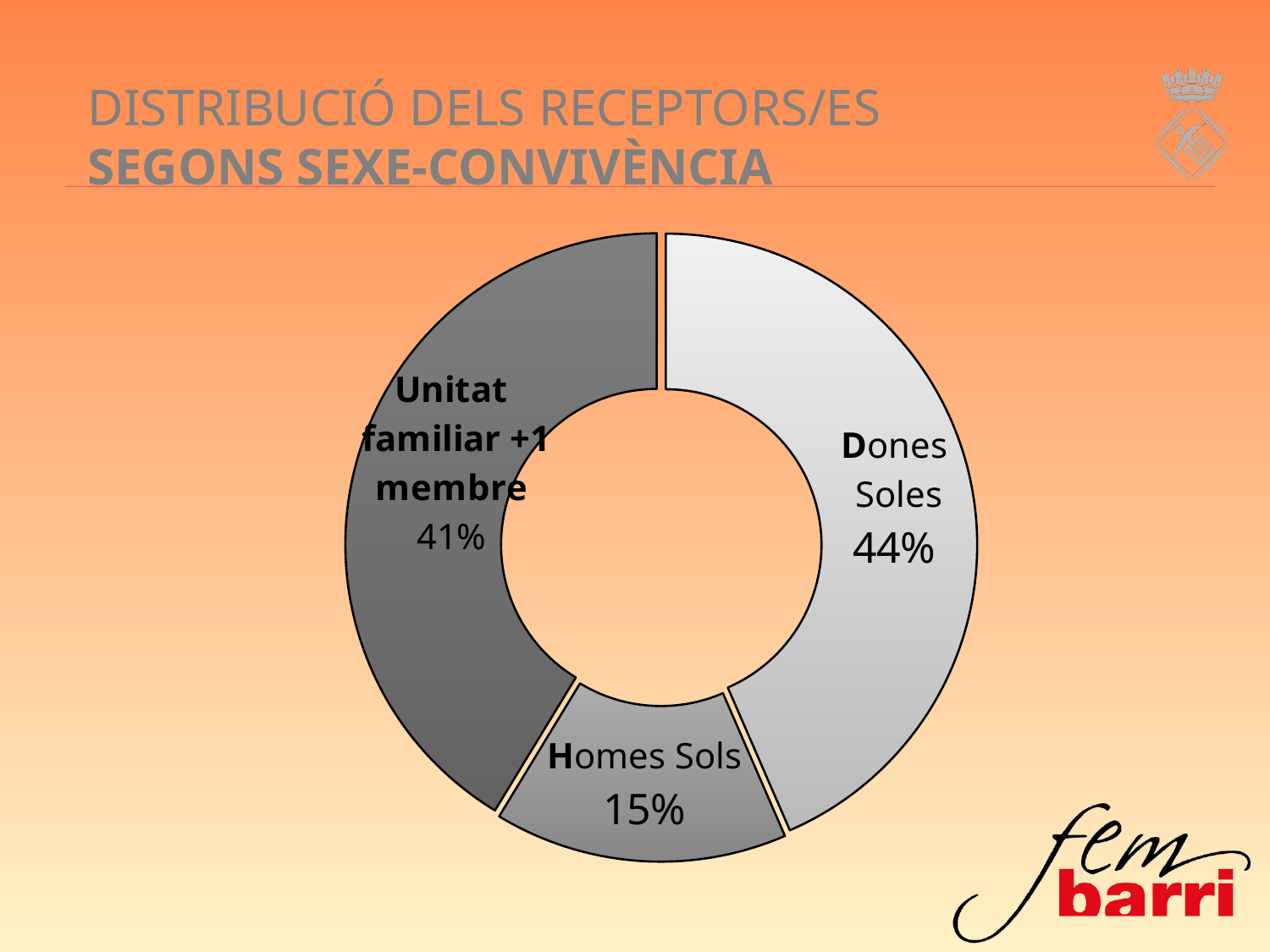
Which is larger, the share for Unitat familiar +1 membre or the share for Homes Sols? Unitat familiar +1 membre What percentage of recipients are Homes Sols? 15% What percentage of recipients are Dones Soles? 44% What is the combined share of Dones Soles and Homes Sols? 59% What is the title of the slide containing the chart? DISTRIBUCIÓ DELS RECEPTORS/ES SEGONS SEXE-CONVIVÈNCIA What percentage of recipients are in the category Unitat familiar +1 membre? 41% What is the difference in percentage points between Dones Soles and Homes Sols? 29 What is the difference in percentage points between Dones Soles and Unitat familiar +1 membre? 3 What kind of chart is shown on the slide? Doughnut (pie) chart How many categories does the chart show? 3 Which category has the largest share of recipients? Dones Soles Which category has the smallest share of recipients? Homes Sols